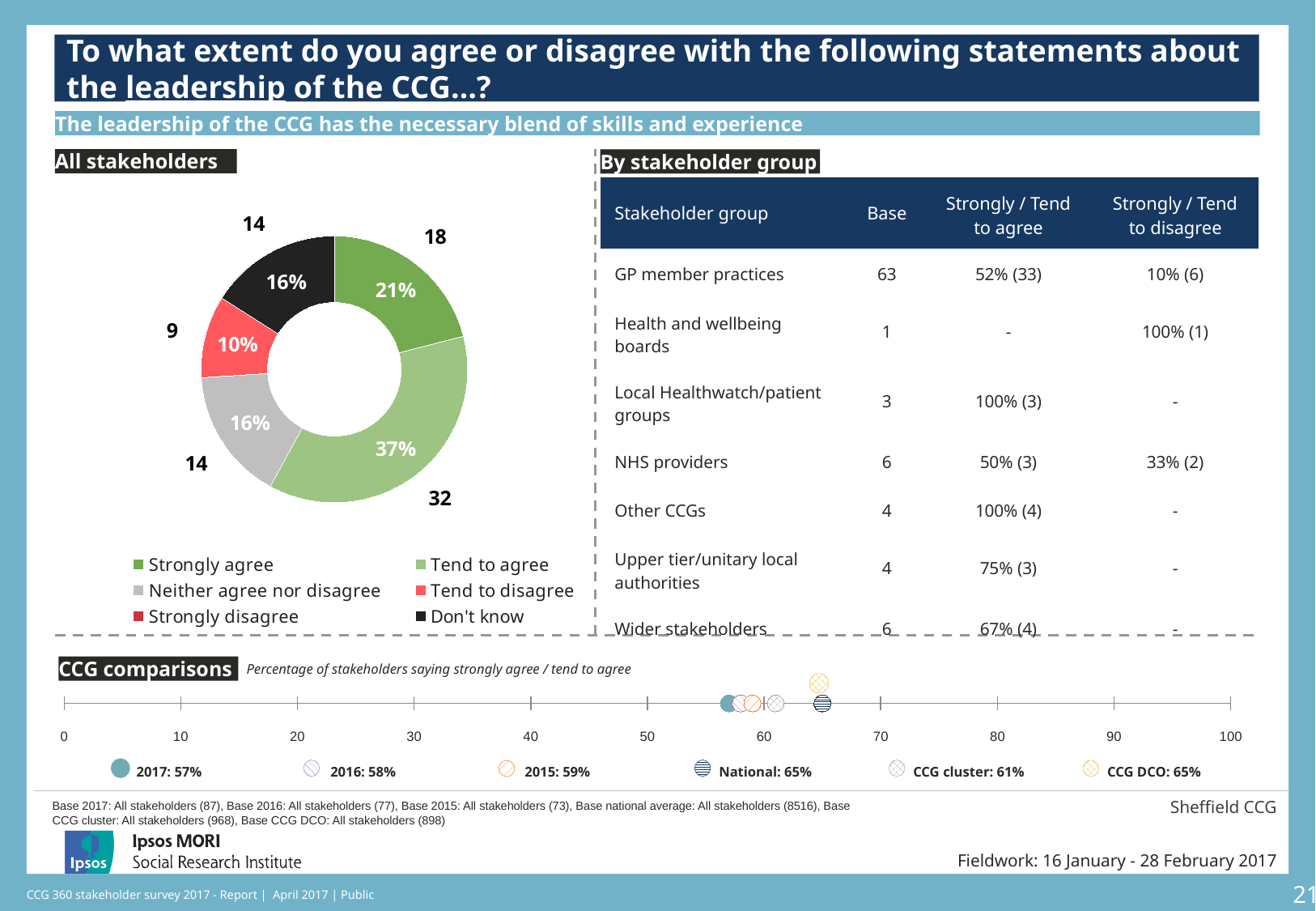
In the CCG comparisons chart, what percentage of stakeholders agreed in 2017? 57% In the All stakeholders donut chart, how many stakeholders answered 'Don't know'? 14 In the CCG comparisons chart, which comparator has the highest percentage: 2017, 2016, 2015 or CCG cluster? CCG cluster In the All stakeholders donut chart, which is larger: the share for 'Neither agree nor disagree' or the share for 'Tend to disagree'? Neither agree nor disagree How many entries does the legend of the All stakeholders donut chart list? 6 In the All stakeholders donut chart, which labelled response category has the smallest share? Tend to disagree In the All stakeholders donut chart, what percentage of stakeholders said they strongly agree? 21% What type of chart is used for the All stakeholders section? Donut (pie) chart In the All stakeholders donut chart, what percentage of stakeholders said they tend to agree? 37% In the All stakeholders donut chart, what is the difference in percentage points between 'Tend to agree' and 'Strongly agree'? 16 percentage points In the CCG comparisons chart, what is the difference between the National figure and the 2017 figure? 8 percentage points In the All stakeholders donut chart, which response category has the largest share? Tend to agree